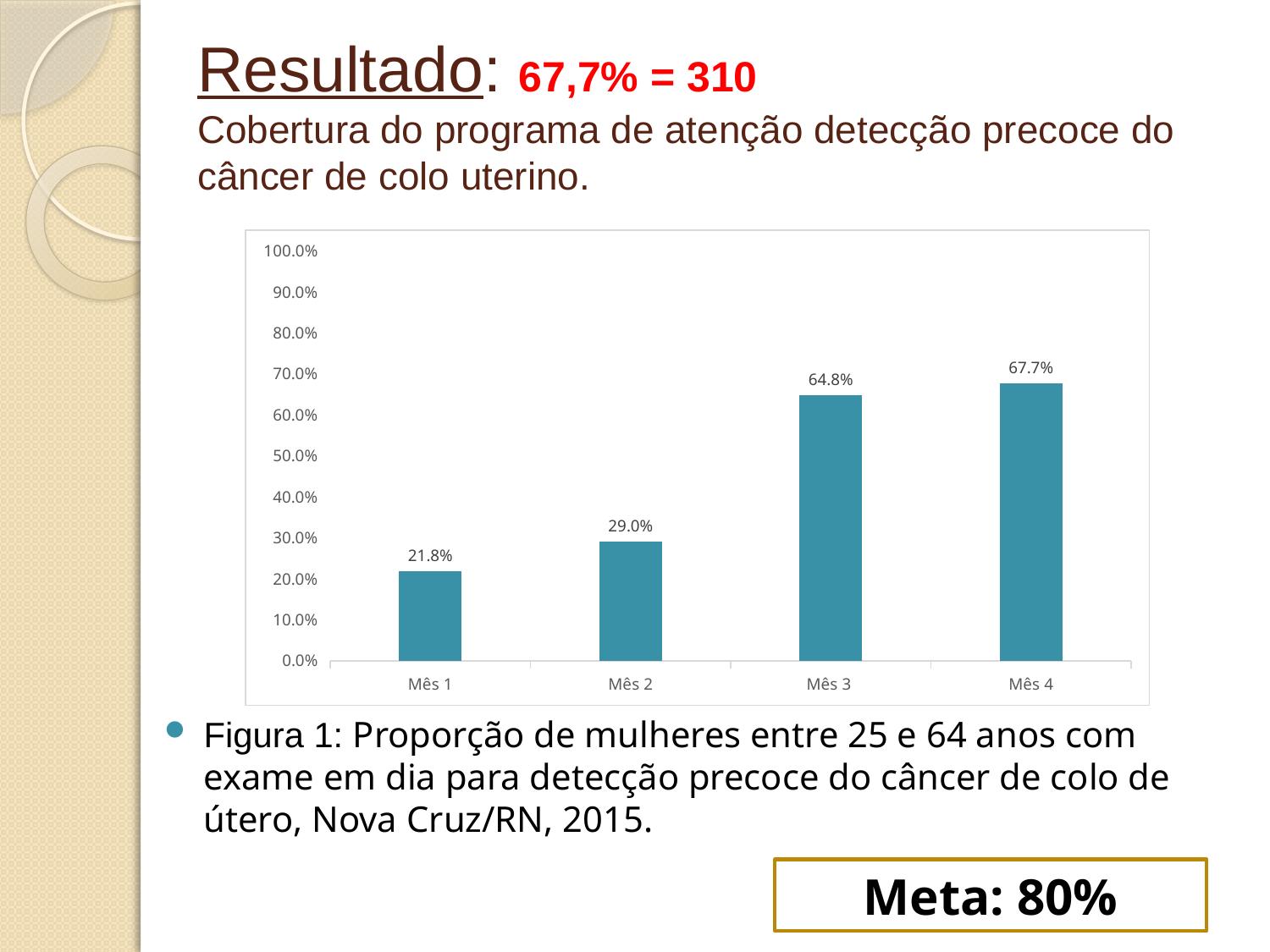
Do the values rise or fall from Mês 1 to Mês 4? rise Is the value for Mês 4 greater or less than 80.0%? less Which is larger, the value for Mês 2 or the value for Mês 3? Mês 3 What is the difference between the values for Mês 2 and Mês 1? 7.2% What is the value for Mês 3? 64.8% Which month has the lowest value? Mês 1 Which month has the highest value? Mês 4 What is the value for Mês 1? 21.8% How many months are shown on the x axis? 4 What is the difference between the values for Mês 3 and Mês 2? 35.8% What kind of chart is shown on the slide? bar chart What is the value for Mês 4? 67.7%